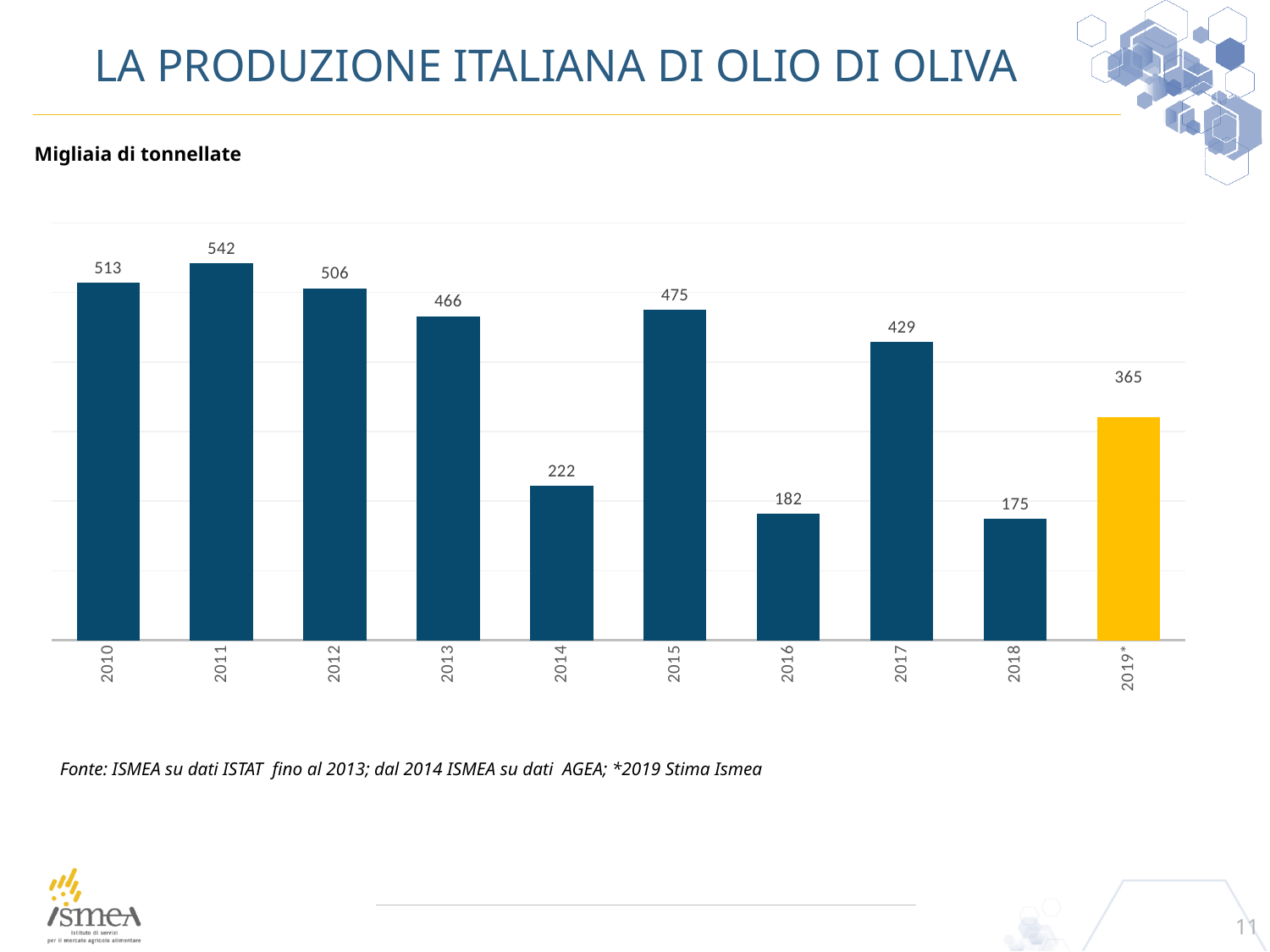
What is the value for 2016? 182 What is the difference between the values for 2010 and 2014? 291 Which year has the lowest value? 2018 What is the value for 2019*? 365 Which bar is coloured differently (yellow) from the others? 2019* What kind of chart is shown on the slide? bar chart Do the values rise or fall from 2015 to 2016? fall How many years are shown on the x axis? 10 Which year has the highest value? 2011 What is the value for 2011? 542 Which is larger, the value for 2013 or the value for 2015? 2015 What is the difference between the values for 2017 and 2018? 254